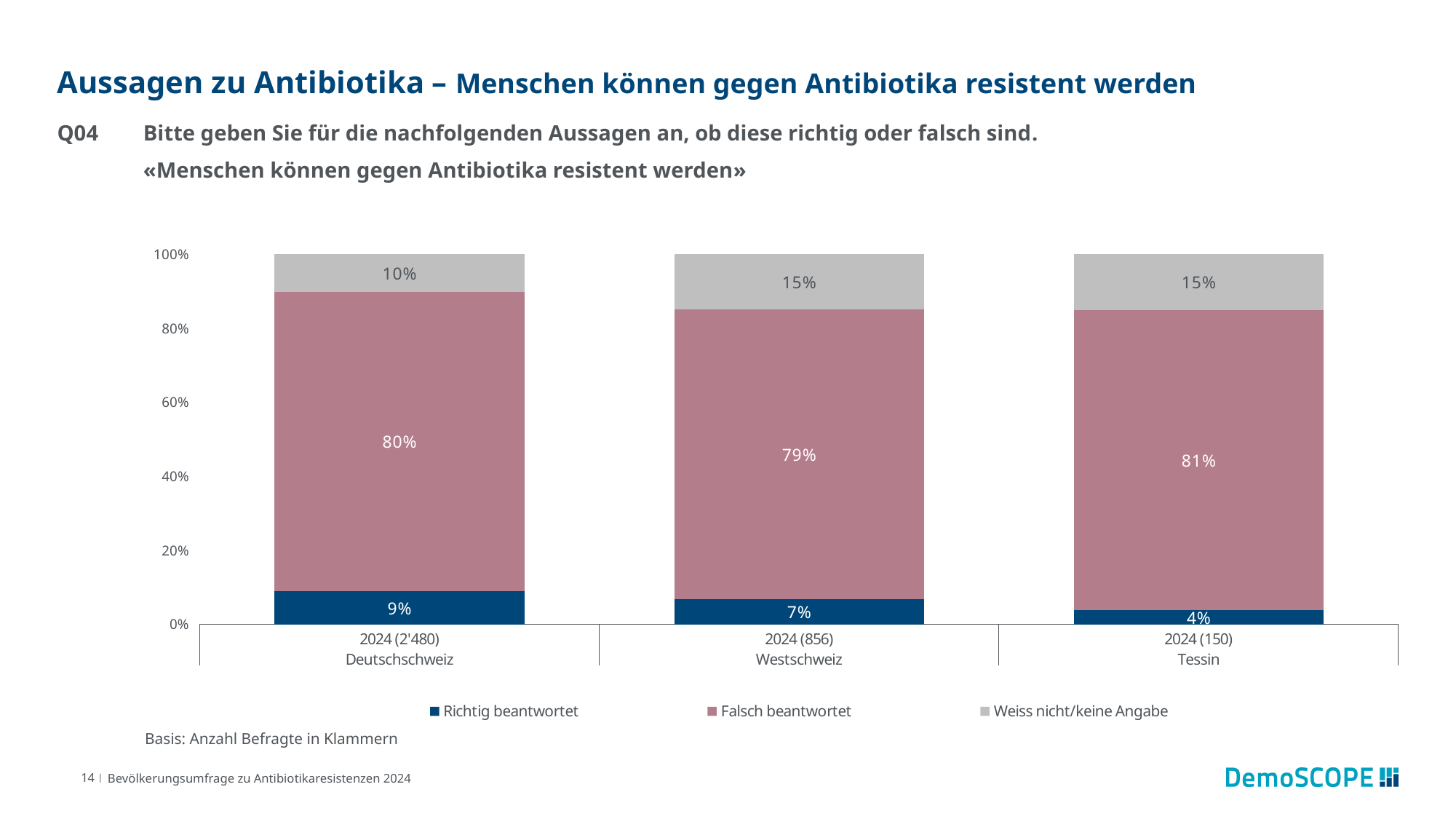
How many respondents are indicated in parentheses for Deutschschweiz? 2'480 What is the value for "Weiss nicht/keine Angabe" in Tessin? 15% Which region has the lowest value for "Richtig beantwortet"? Tessin What is the difference between the "Richtig beantwortet" values for Deutschschweiz and Tessin? 5% What is the value for "Falsch beantwortet" in Westschweiz? 79% What is the total of the stacked bar for Westschweiz? 101% Which region has the highest value for "Falsch beantwortet"? Tessin What kind of chart is shown on the slide? Stacked bar chart How many regions (bars) are shown in the chart? 3 What is the value for "Richtig beantwortet" in Deutschschweiz? 9% How many series does the legend list? 3 Is the "Weiss nicht/keine Angabe" value larger in Deutschschweiz or in Westschweiz? Westschweiz